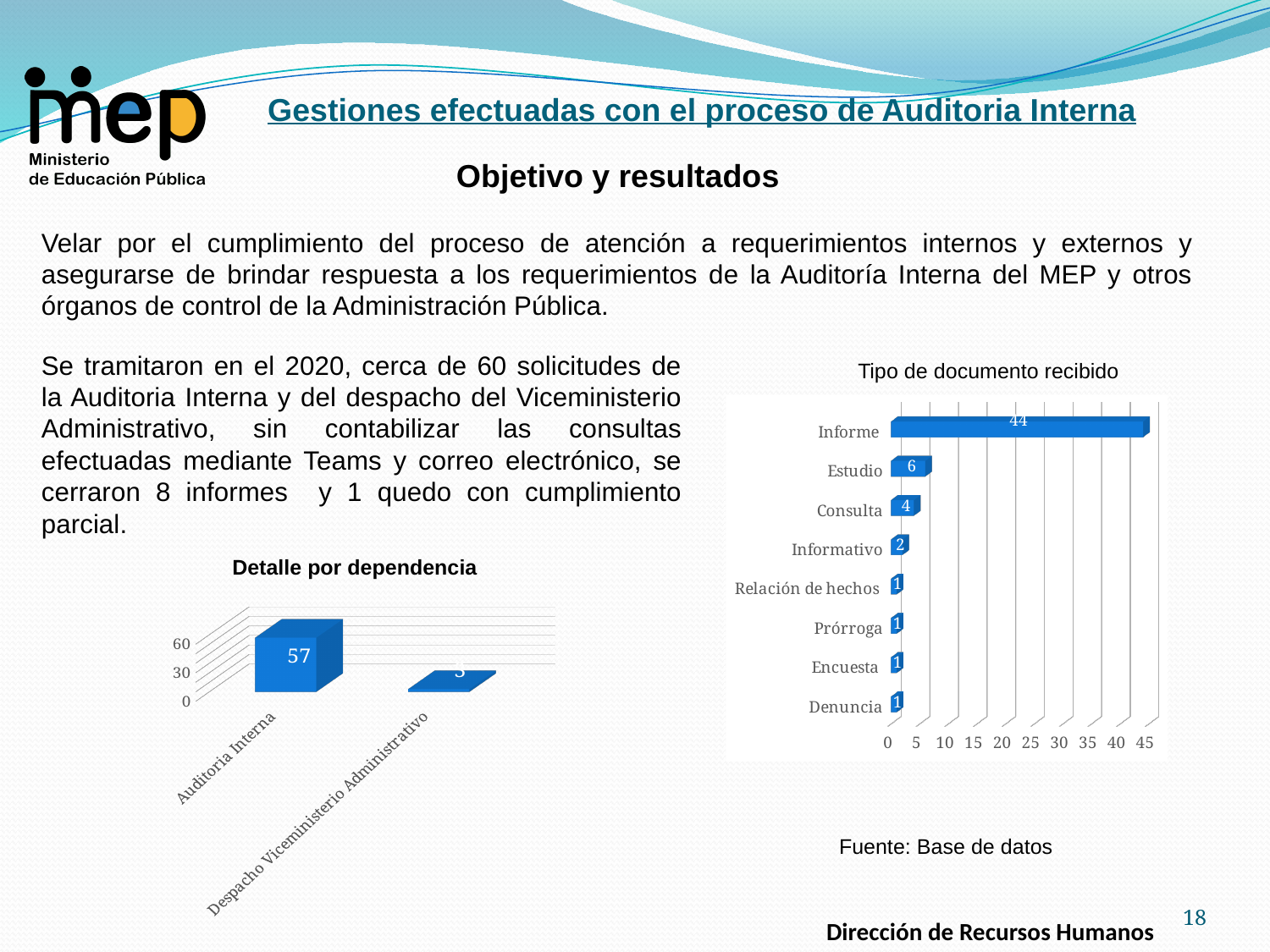
In the 'Detalle por dependencia' chart, what is the value for Auditoria Interna? 57 In the 'Tipo de documento recibido' chart, is the value for Informe greater or less than 40? greater In the 'Tipo de documento recibido' chart, which is larger, Consulta or Informativo? Consulta In the 'Detalle por dependencia' chart, which dependency has the highest value? Auditoria Interna In the 'Detalle por dependencia' chart, is the value for Despacho Viceministerio Administrativo greater or less than 30? less In the 'Tipo de documento recibido' chart, what is the value for Estudio? 6 In the 'Tipo de documento recibido' chart, what is the difference between Informe and Estudio? 38 In the 'Tipo de documento recibido' chart, what is the value for Informativo? 2 In the 'Tipo de documento recibido' chart, which document type has the highest value? Informe In the 'Tipo de documento recibido' chart, what is the value for Informe? 44 In the 'Tipo de documento recibido' chart, what is the value for Consulta? 4 In the 'Tipo de documento recibido' chart, how many document types are listed? 8